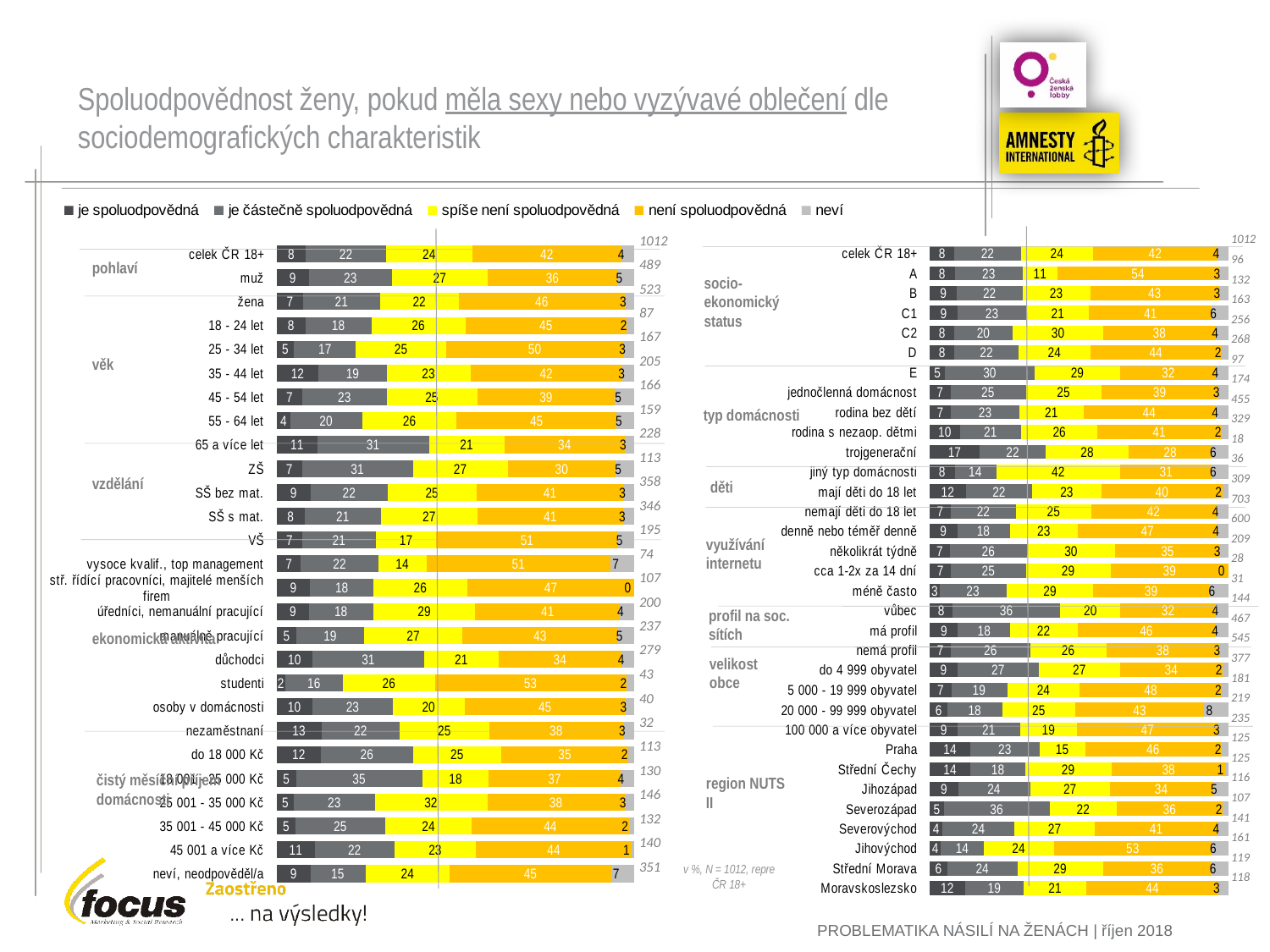
In the left chart, what is the value of 'není spoluodpovědná' for 'žena'? 46 How many series does the legend list? 5 In the right chart, which region NUTS II has the lowest value for 'je spoluodpovědná'? Severovýchod and Jihovýchod (both 4) What kind of chart is shown on the slide? Stacked bar chart In the right chart, what is the value of 'neví' for '20 000 - 99 999 obyvatel'? 8 In the right chart, what is the value of 'není spoluodpovědná' for socio-economic status 'A'? 54 In the left chart, what is the difference between the 'není spoluodpovědná' values for 'studenti' and 'důchodci'? 19 In the left chart, which age group has the highest value for 'není spoluodpovědná'? 25 - 34 let In the left chart, what is the value of 'je částečně spoluodpovědná' for '65 a více let'? 31 In the right chart, which is larger: the 'není spoluodpovědná' value for 'Praha' or for 'Jihozápad'? Praha In the left chart, what is the value of 'spíše není spoluodpovědná' for '25 001 - 35 000 Kč'? 32 In the right chart, what is the value of 'je spoluodpovědná' for 'trojgenerační'? 17